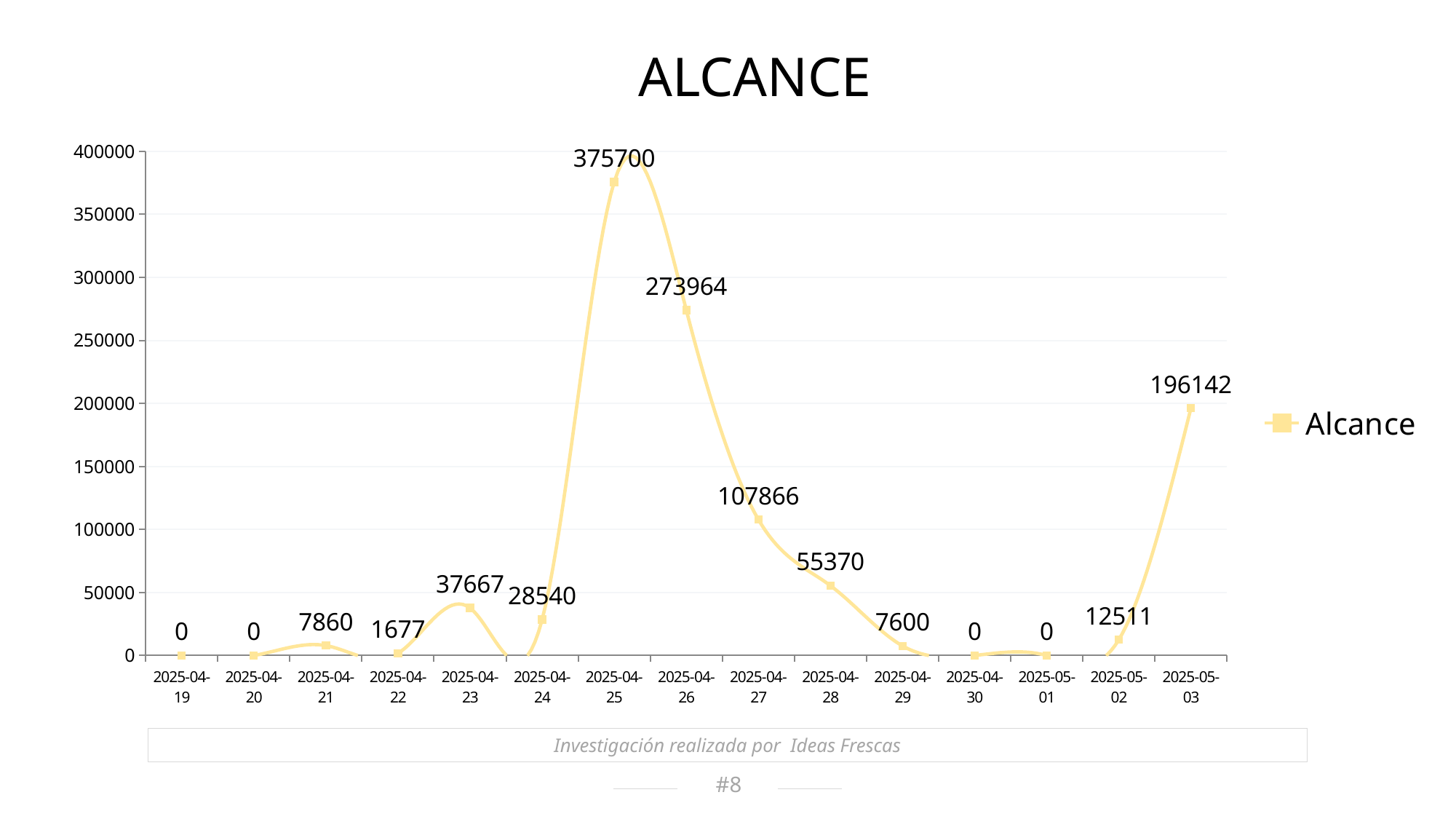
What is the value for 2025-05-03? 196142 Which date has the highest value? 2025-04-25 How many dates are plotted on the x axis? 15 Which is larger, the value for 2025-04-26 or the value for 2025-05-03? 2025-04-26 Is the value for 2025-04-26 greater or less than 250000? greater What is the difference between the values for 2025-04-27 and 2025-04-28? 52496 Do the values rise or fall from 2025-04-25 to 2025-04-29? fall How many series does the legend list? 1 What is the difference between the values for 2025-04-25 and 2025-04-26? 101736 What kind of chart is shown? line chart What is the value for 2025-04-25? 375700 What is the value for 2025-04-23? 37667